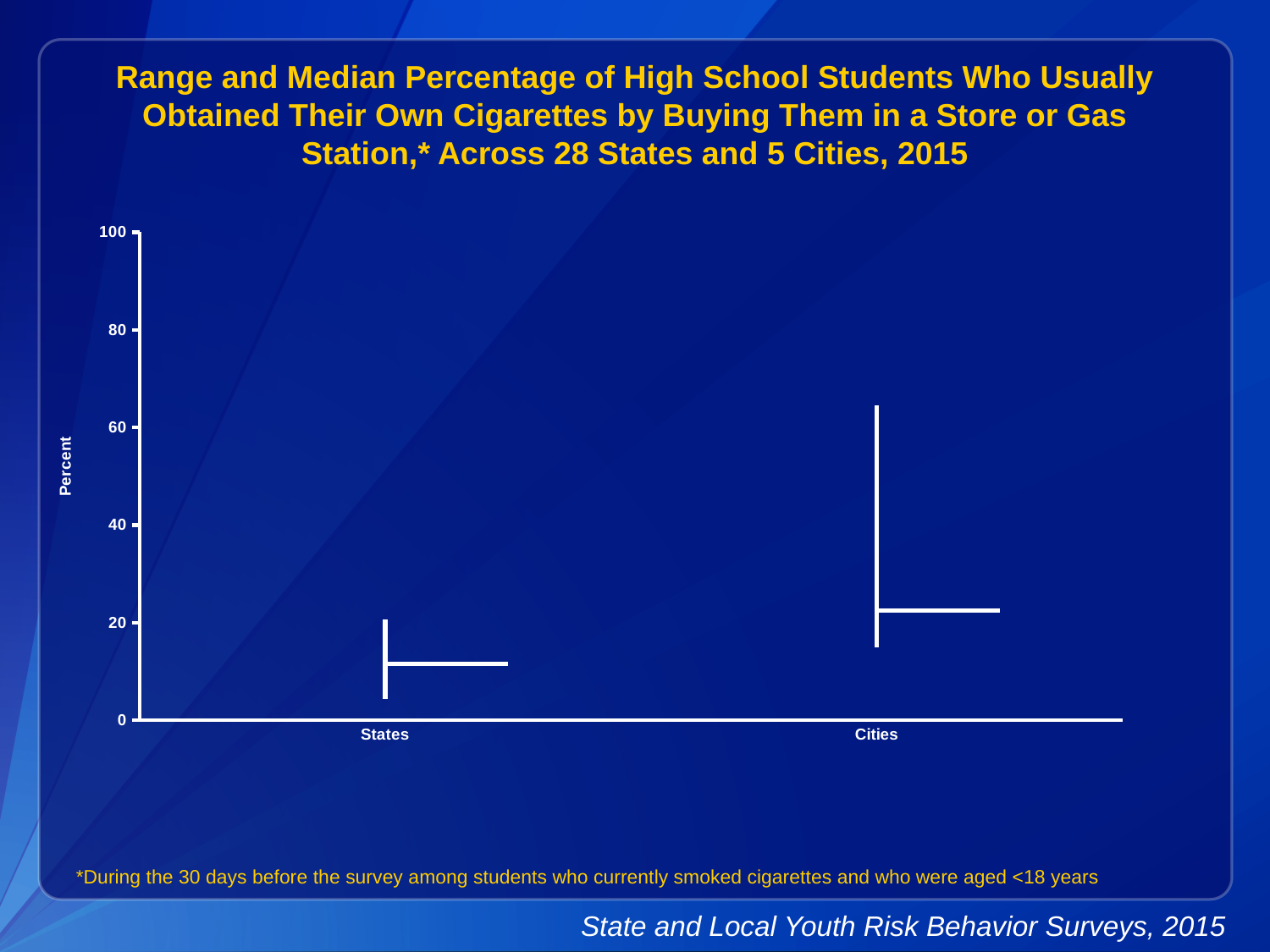
What is the highest value shown on the y axis? 100 Is the median value for States greater or less than 20? less Is the top of the range for States greater or less than 40? less Is the top of the range for Cities greater or less than 60? greater How many categories are shown on the x axis of the chart? 2 What is the label of the y axis? Percent Which category has the lower median percentage? States What are the two categories shown on the x axis? States and Cities Which category shows the larger range of percentages? Cities Which category has the higher median percentage, States or Cities? Cities